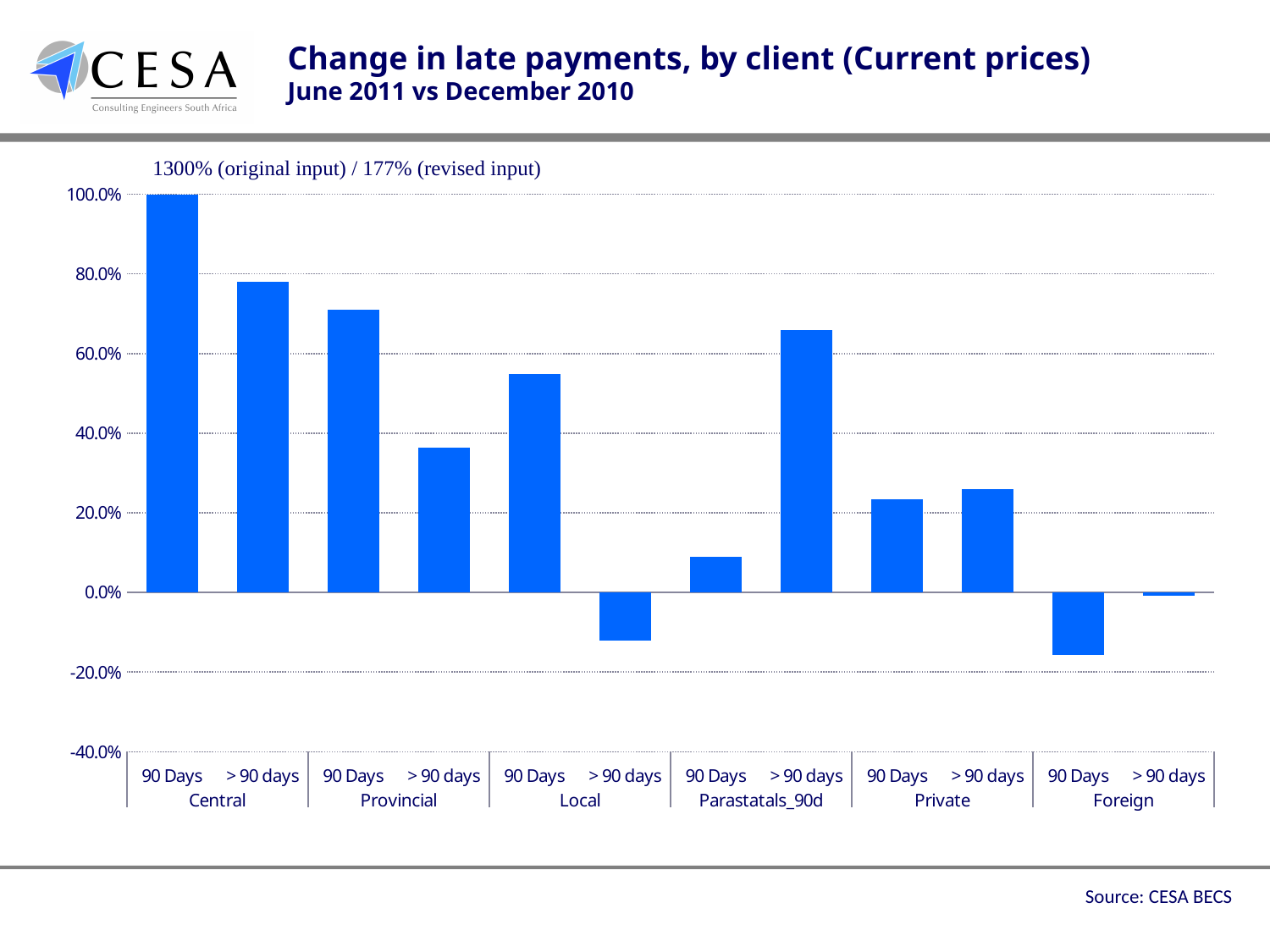
How many client groups are shown along the x axis? 6 What is the title of the chart? Change in late payments, by client (Current prices) Which bar shows the highest value in the chart? Central, 90 Days Is the value for Central > 90 days greater or less than 60.0%? greater Is the value for Parastatals_90d > 90 days greater or less than 60.0%? greater Which is larger, the value for Provincial 90 Days or Local 90 Days? Provincial 90 Days Which bar shows the lowest value in the chart? Foreign, 90 Days How many bars are plotted in the chart? 12 What kind of chart is shown on the slide? Bar chart Is the value for Local > 90 days greater or less than 0.0%? less Which is larger, the value for Parastatals_90d 90 Days or Parastatals_90d > 90 days? Parastatals_90d > 90 days